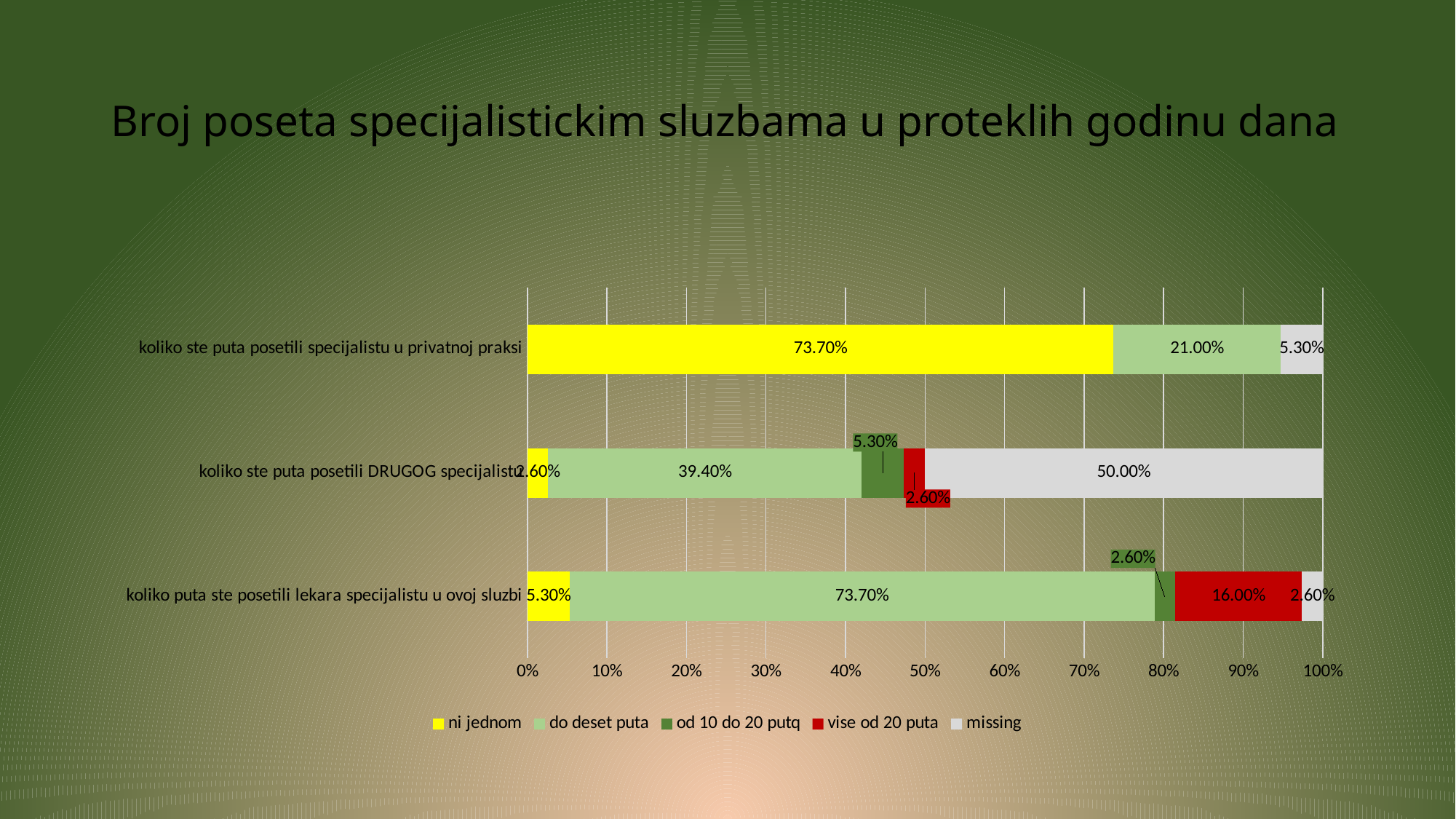
Which category has the lowest 'ni jednom' value? koliko ste puta posetili DRUGOG specijalistu What is the value of 'do deset puta' for 'koliko ste puta posetili DRUGOG specijalistu'? 39.40% What is the value of 'vise od 20 puta' for 'koliko puta ste posetili lekara specijalistu u ovoj sluzbi'? 16.00% How many series does the legend list? 5 Which is larger: the 'missing' value for 'koliko ste puta posetili specijalistu u privatnoj praksi' or for 'koliko puta ste posetili lekara specijalistu u ovoj sluzbi'? koliko ste puta posetili specijalistu u privatnoj praksi What type of chart is shown on the slide? stacked bar chart What is the value of 'ni jednom' for 'koliko ste puta posetili specijalistu u privatnoj praksi'? 73.70% How many categories (bars) are shown in the chart? 3 What is the value of 'missing' for 'koliko ste puta posetili DRUGOG specijalistu'? 50.00% What is the title of the chart? Broj poseta specijalistickim sluzbama u proteklih godinu dana What is the difference between the 'do deset puta' values for 'koliko puta ste posetili lekara specijalistu u ovoj sluzbi' and 'koliko ste puta posetili specijalistu u privatnoj praksi'? 52.70% Which category has the highest 'missing' value? koliko ste puta posetili DRUGOG specijalistu